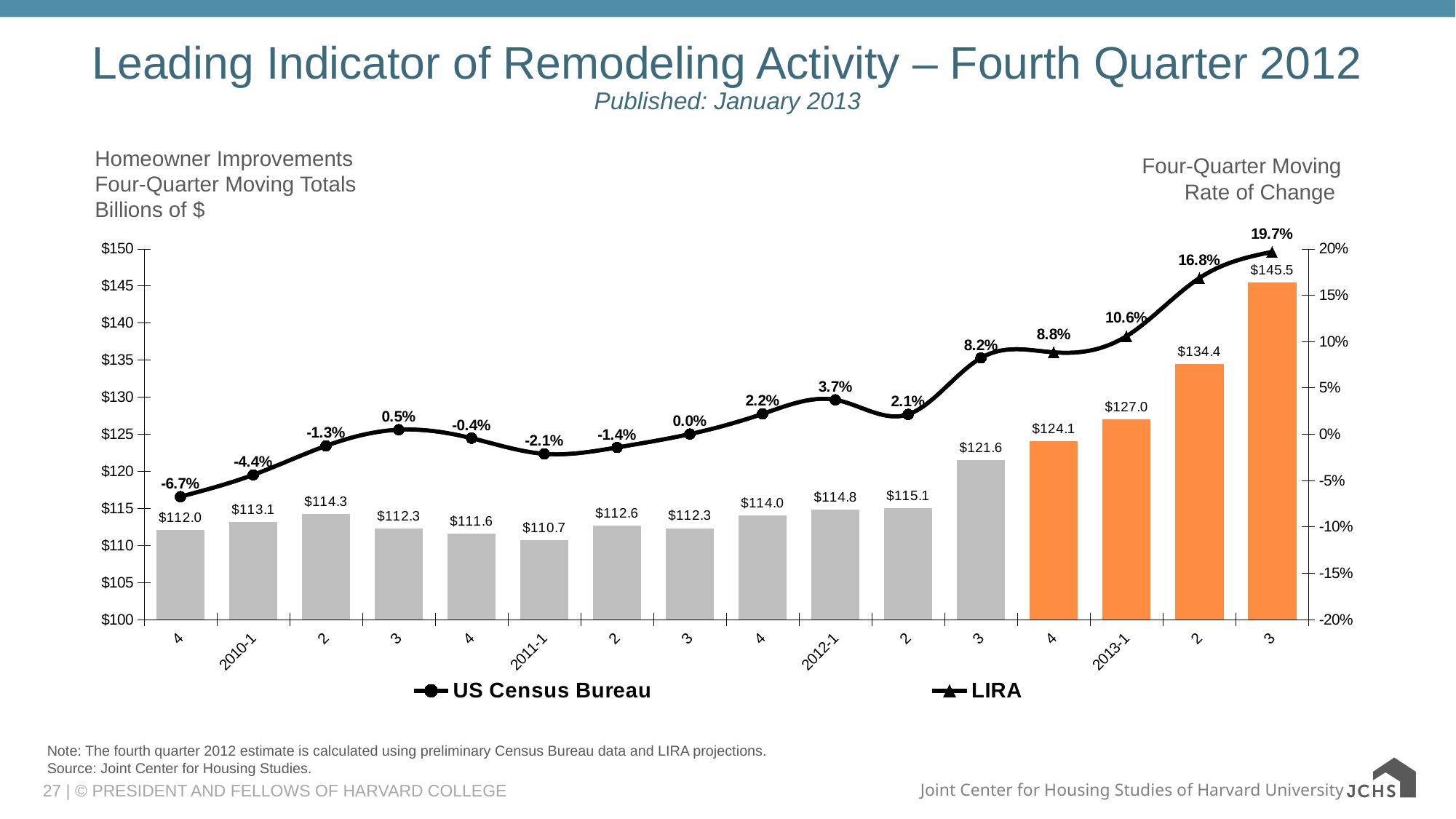
What is the four-quarter moving total for 2013-1? $127.0 Which is larger, the four-quarter moving total for 2010 Q2 or for 2012-1? 2012-1 What is the four-quarter moving rate of change for 2012-1? 3.7% Is the four-quarter moving total for 2012 Q3 greater or less than $120? greater How many quarters (bars) are plotted on the chart? 16 What kind of chart is shown on the slide? Combined bar and line chart Which quarter has the highest four-quarter moving total? 2013 Q3 ($145.5) How many series does the legend list? 2 Which quarter has the lowest four-quarter moving total? 2011-1 ($110.7) What is the lowest four-quarter moving rate of change shown on the line? -6.7% Does the four-quarter moving rate of change rise or fall from 2012 Q3 to 2013 Q3? Rises What is the difference between the four-quarter moving totals for 2013 Q3 and 2013 Q2? $11.1